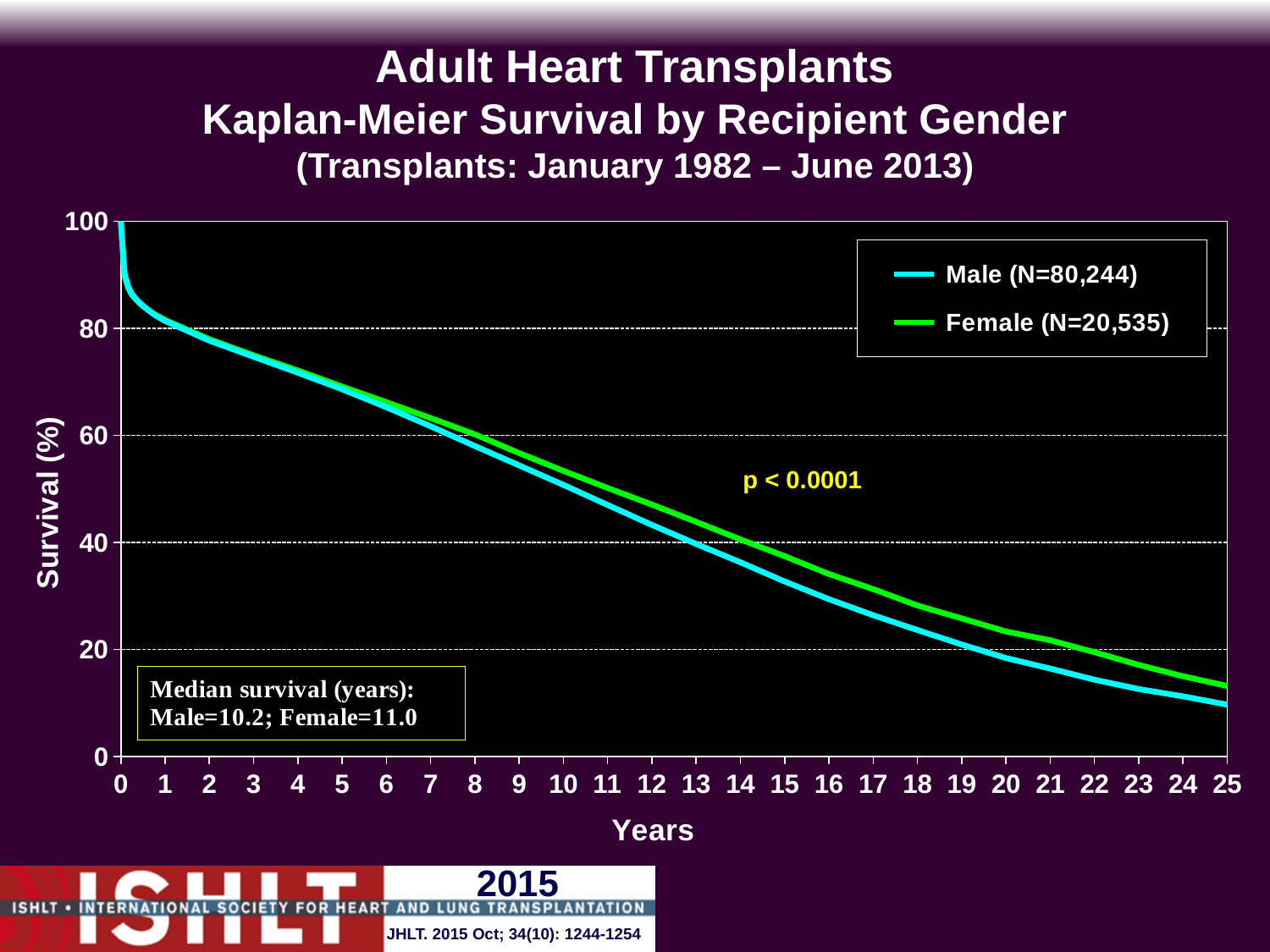
What is the median survival in years for female recipients? 11.0 Is the survival for Male recipients at 10 years greater or less than 40%? greater At 15 years, which group has higher survival, Male or Female? Female What is the number of female recipients (N) shown in the legend? 20,535 What kind of chart is shown on the slide? line chart Which colour represents the Male series? cyan How many series does the legend list? 2 Is the survival for Female recipients at 25 years greater or less than 20%? less What is the number of male recipients (N) shown in the legend? 80,244 Do the survival curves rise or fall as years increase? fall What p-value is shown on the chart? p < 0.0001 What is the median survival in years for male recipients? 10.2